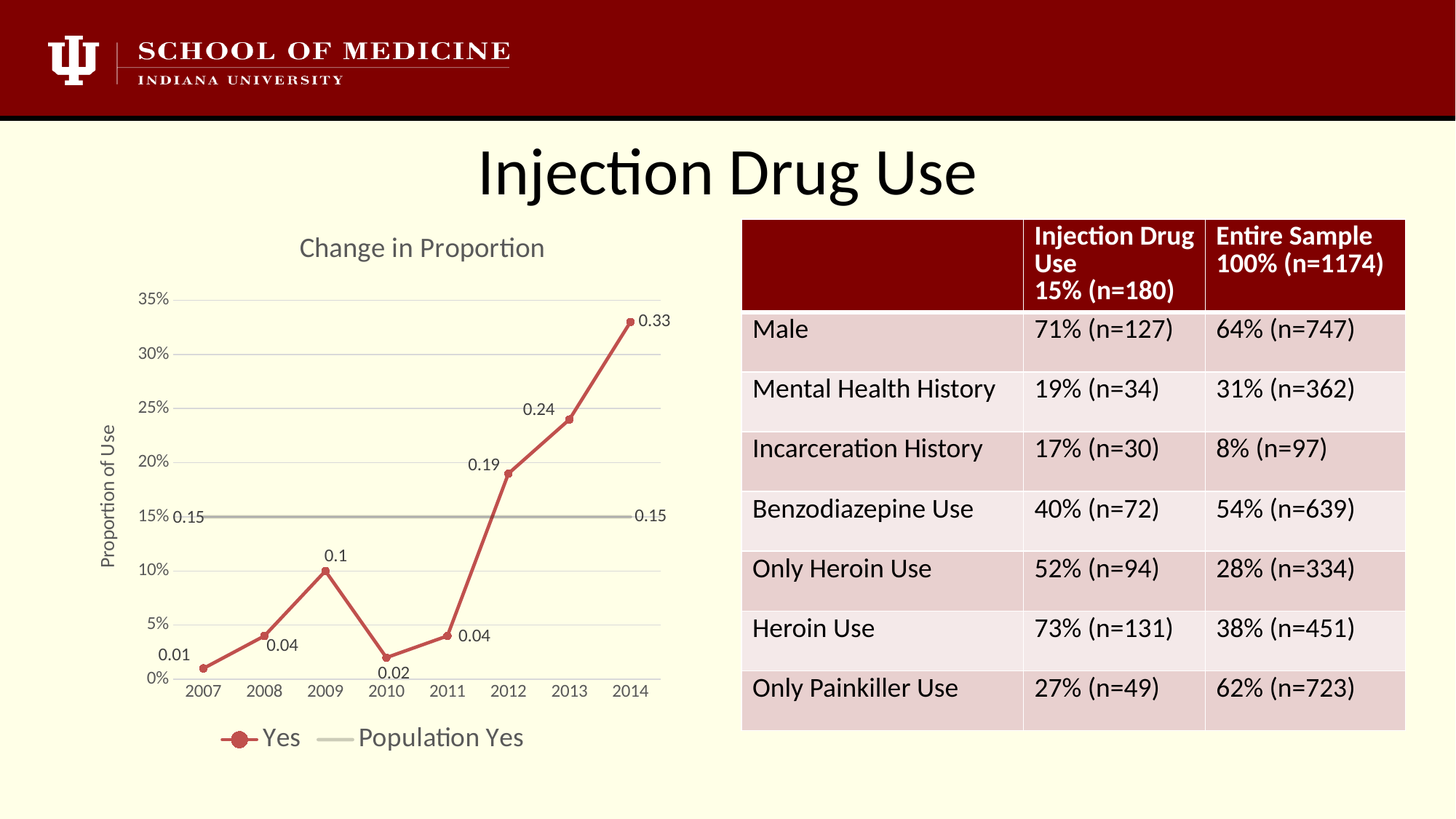
Which is larger in the Change in Proportion chart: the Yes value for 2009 or for 2010? 2009 What is the value of the Population Yes series in the Change in Proportion chart? 0.15 What kind of chart is the Change in Proportion chart? line chart How many years are shown on the x axis of the Change in Proportion chart? 8 What is the value of the Yes series in 2009 in the Change in Proportion chart? 0.1 Is the Yes value for 2013 in the Change in Proportion chart greater or less than 20%? greater What is the value of the Yes series in 2012 in the Change in Proportion chart? 0.19 What is the value of the Yes series in 2014 in the Change in Proportion chart? 0.33 Which year has the lowest value for the Yes series in the Change in Proportion chart? 2007 What is the difference between the Yes values for 2014 and 2013 in the Change in Proportion chart? 0.09 How many series does the legend of the Change in Proportion chart list? 2 Which year has the highest value for the Yes series in the Change in Proportion chart? 2014